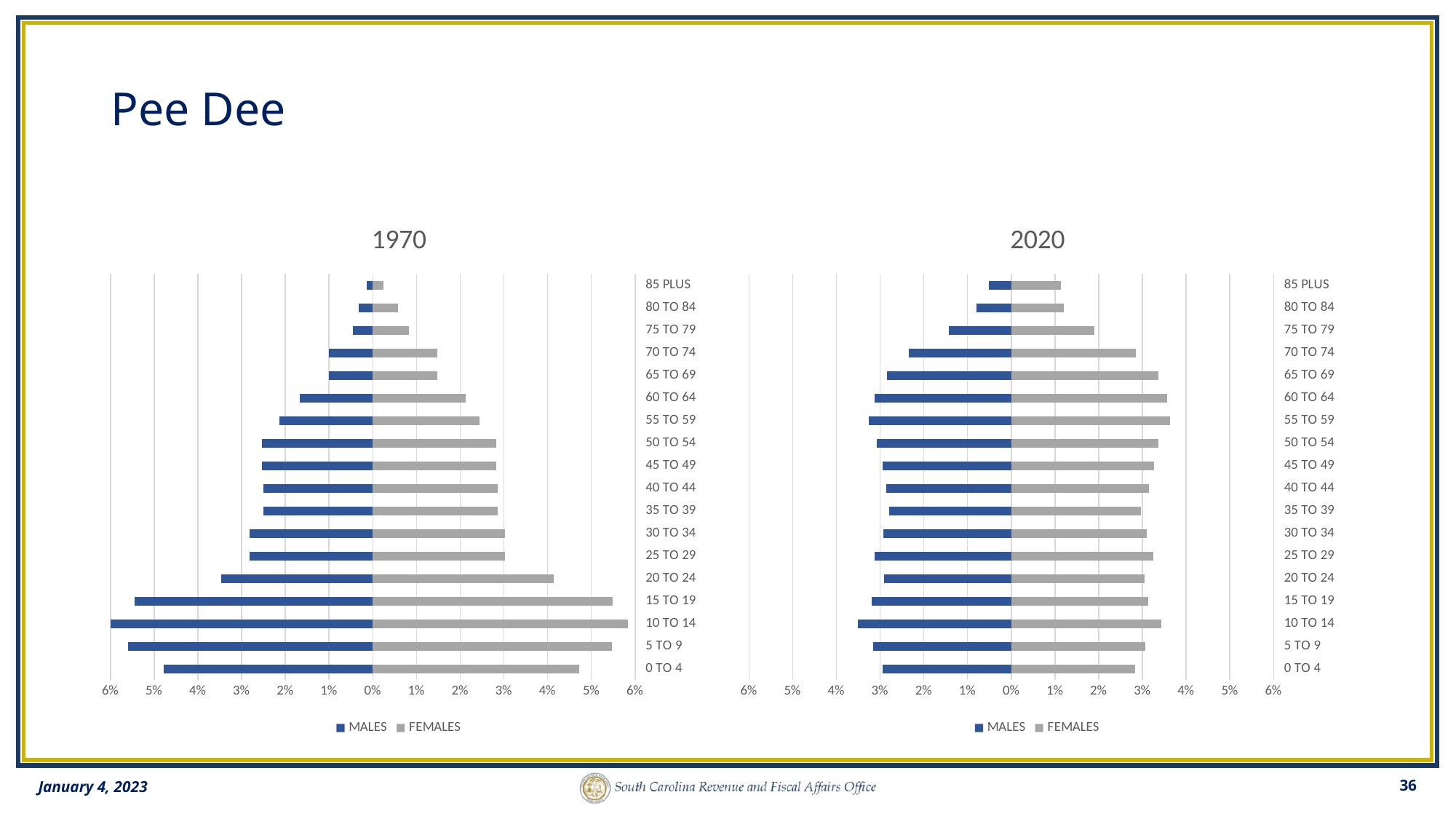
In the 1970 chart, which is larger, the MALES value for 20 TO 24 or the MALES value for 25 TO 29? 20 TO 24 In the 1970 chart, which age group has the shortest FEMALES bar? 85 PLUS In the 2020 chart, which age group has the longest MALES bar? 10 TO 14 In the 2020 chart, which age group has the shortest MALES bar? 85 PLUS In the 1970 chart, is the MALES value for 60 TO 64 greater or less than 2%? less What kind of chart is the 1970 chart? bar chart In the 1970 chart, is the MALES value for 0 TO 4 greater or less than 4%? greater How many series does the legend of the 1970 chart list? 2 In the 1970 chart, which age group has the longest MALES bar? 10 TO 14 What are the two series named in the legend of the 2020 chart? MALES and FEMALES In the 2020 chart, is the FEMALES value for 70 TO 74 greater or less than 3%? less How many age-group categories does the 2020 chart show? 18